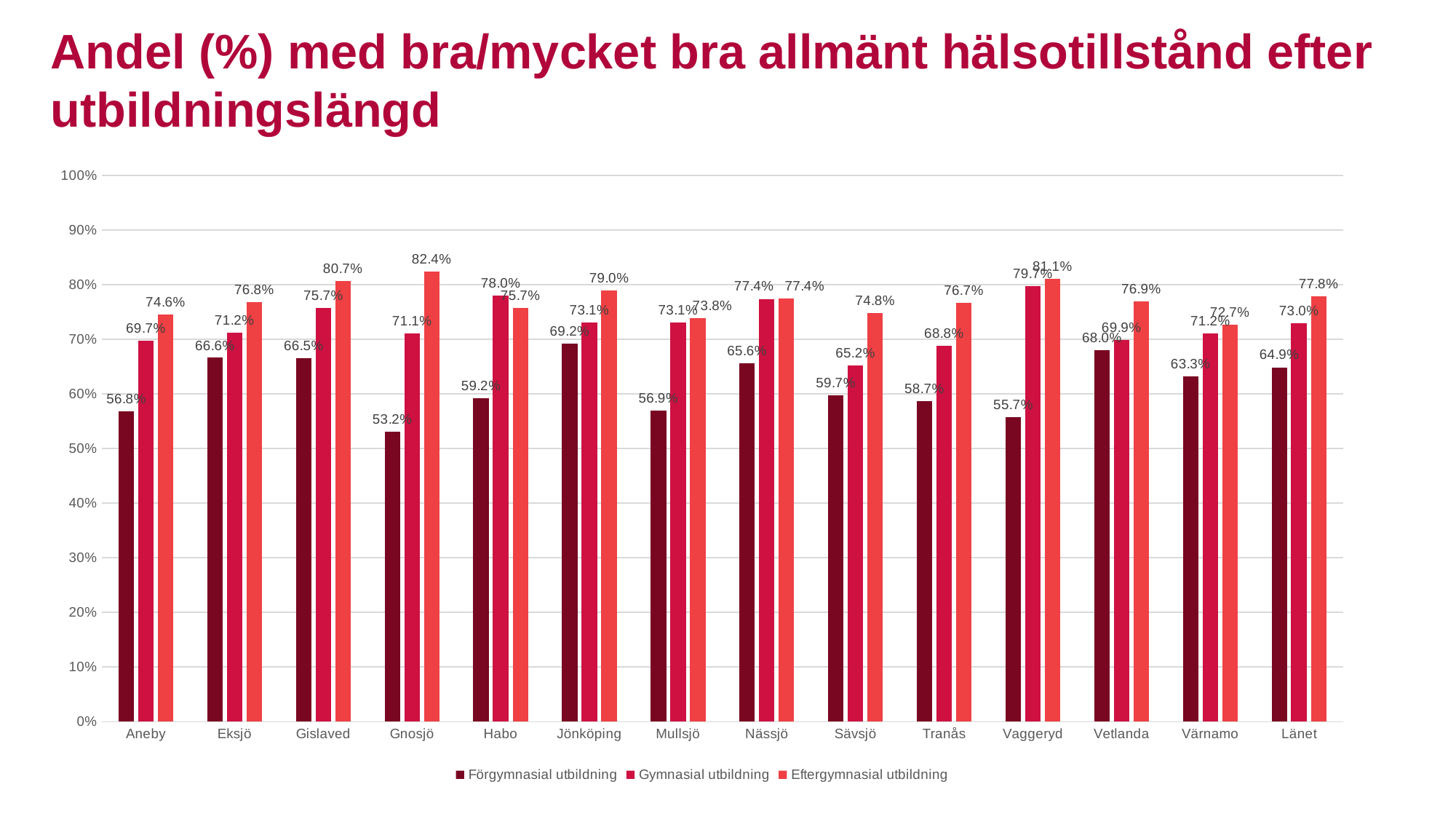
Which category has the highest value for Eftergymnasial utbildning? Gnosjö Which category has the highest value for Förgymnasial utbildning? Jönköping How many series does the legend list? 3 Is the value for Förgymnasial utbildning in Vaggeryd greater or less than 60%? less What is the value for Förgymnasial utbildning in Gnosjö? 53.2% Which category has the lowest value for Förgymnasial utbildning? Gnosjö What kind of chart is shown on the slide? Bar chart What is the value for Gymnasial utbildning in Länet? 73.0% What is the value for Eftergymnasial utbildning in Vaggeryd? 81.1% How many categories are shown on the x axis? 14 What is the difference between Eftergymnasial utbildning and Förgymnasial utbildning in Gnosjö? 29.2 percentage points In Habo, which is larger: Gymnasial utbildning or Eftergymnasial utbildning? Gymnasial utbildning